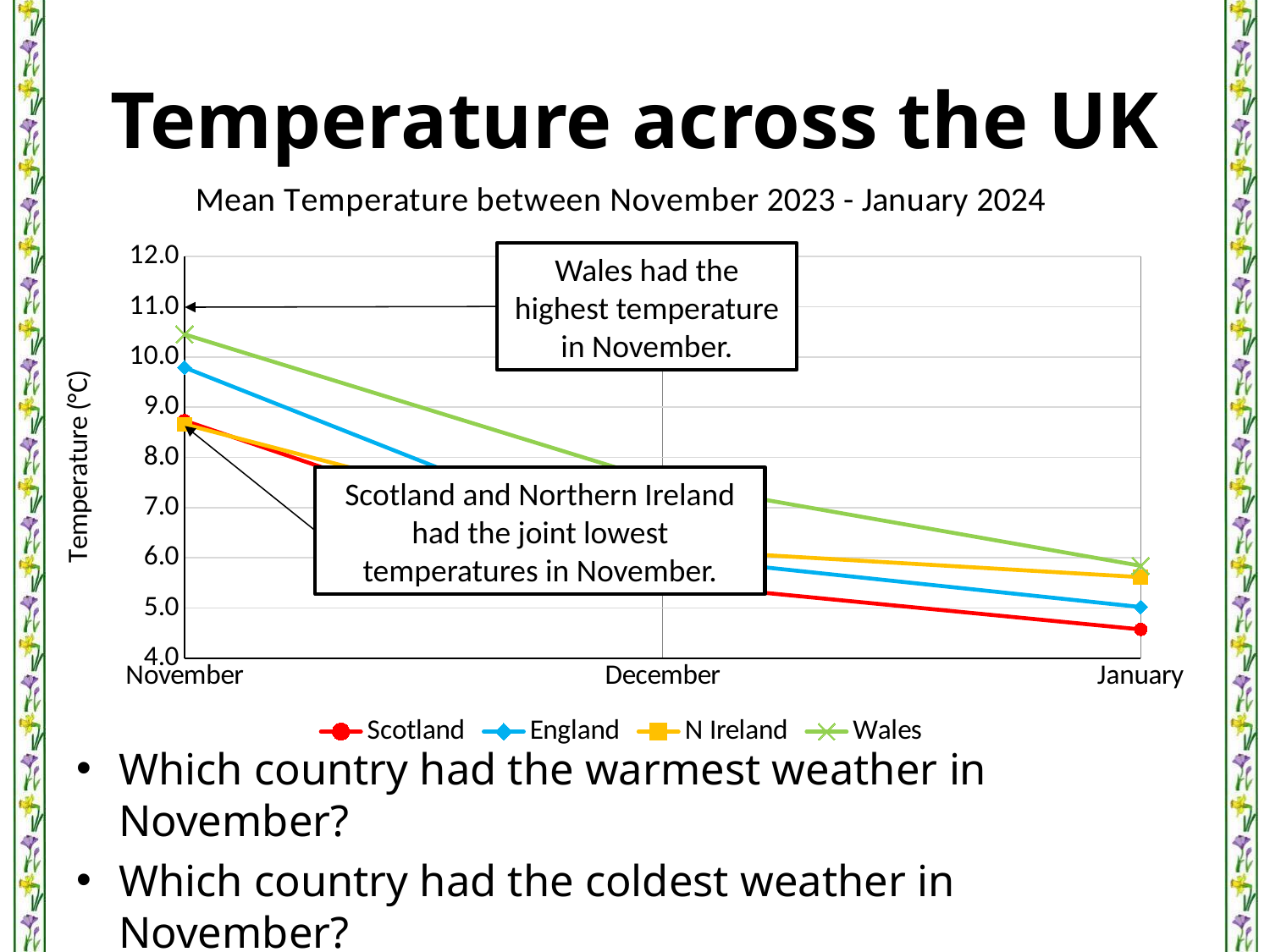
How many months are shown along the x axis? 3 Which is larger in January, the value for England or the value for Scotland? England How many series does the legend list? 4 Which is larger in November, the value for Wales or the value for England? Wales Is the value for Scotland in January greater or less than 5.0? less Is the value for Wales in November greater or less than 10.0? greater Do the temperatures rise or fall from November to January? Fall Which country had the lowest mean temperature in January? Scotland Which country had the highest mean temperature in November? Wales What kind of chart is shown on the slide? Line chart Is the value for England in November greater or less than 9.0? greater What is the title of the chart? Mean Temperature between November 2023 - January 2024